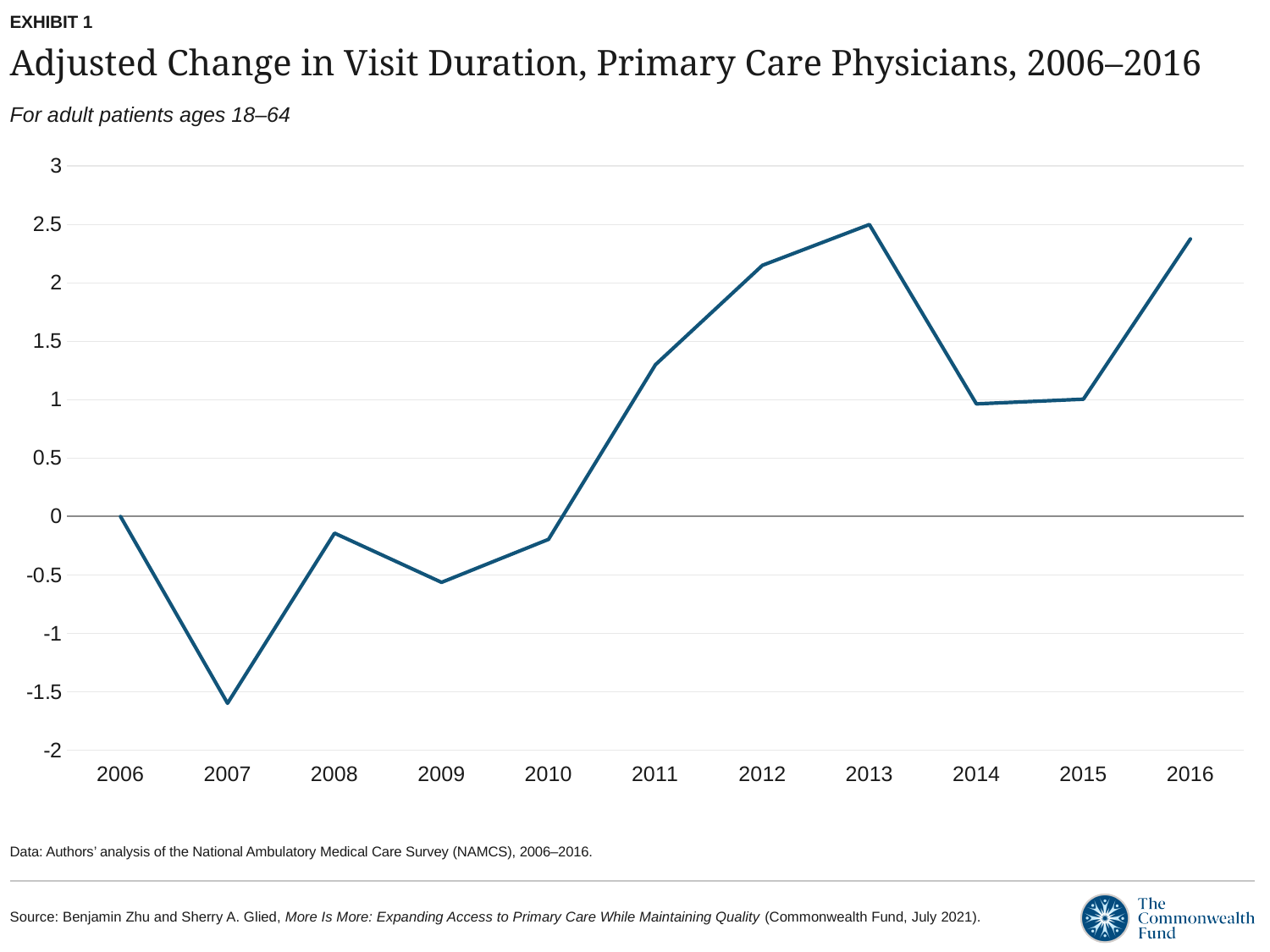
Which year has the larger value, 2011 or 2012? 2012 What is the title of the chart? Adjusted Change in Visit Duration, Primary Care Physicians, 2006–2016 Is the value for 2012 greater or less than 2? greater Which year has the lowest adjusted change in visit duration? 2007 Do the values rise or fall from 2010 to 2013? rise Which year has the highest adjusted change in visit duration? 2013 What kind of chart is shown on the slide? line chart What is the adjusted change in visit duration for 2006? 0 Is the value for 2007 greater or less than -1.5? less How many years are plotted on the x axis? 11 Is the value for 2016 greater or less than 2? greater